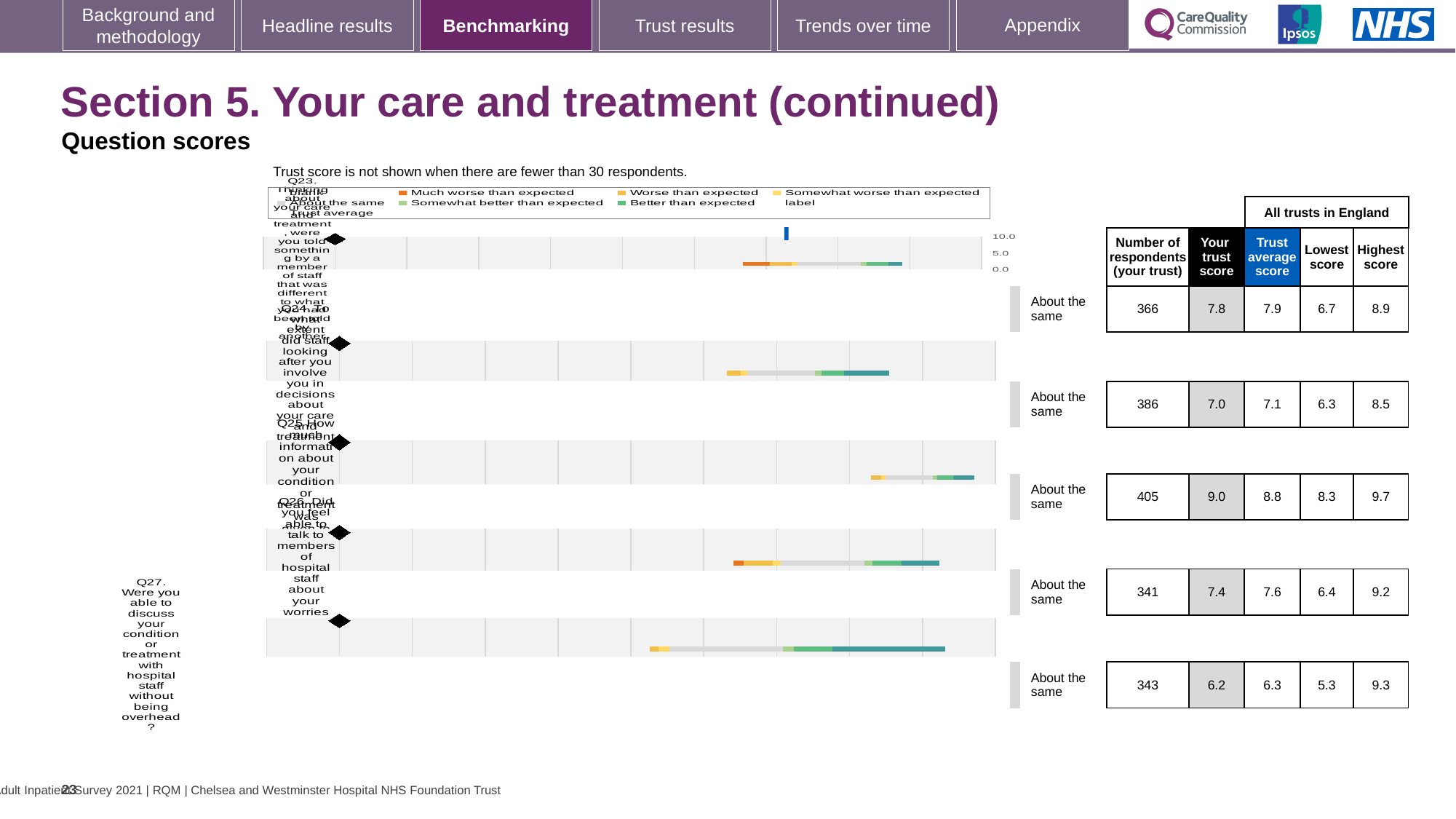
What benchmark category is shown for Q23? About the same Which has the higher 'Your trust score', Q23 or Q26? Q23 Which question has the highest 'Your trust score'? Q25 What is the Highest score across all trusts in England for Q27? 9.3 Which question has the lowest 'Your trust score'? Q27 How many respondents (your trust) are shown for Q24? 386 What kind of chart is used to show the question scores? Bar chart What is the Lowest score across all trusts in England for Q24? 6.3 How many questions (rows) are plotted on the chart? 5 What is the difference between the 'Your trust score' for Q25 and for Q27? 2.8 What is the 'Your trust score' for Q27 (discussing your condition or treatment without being overheard)? 6.2 What is the Trust average score for Q25? 8.8